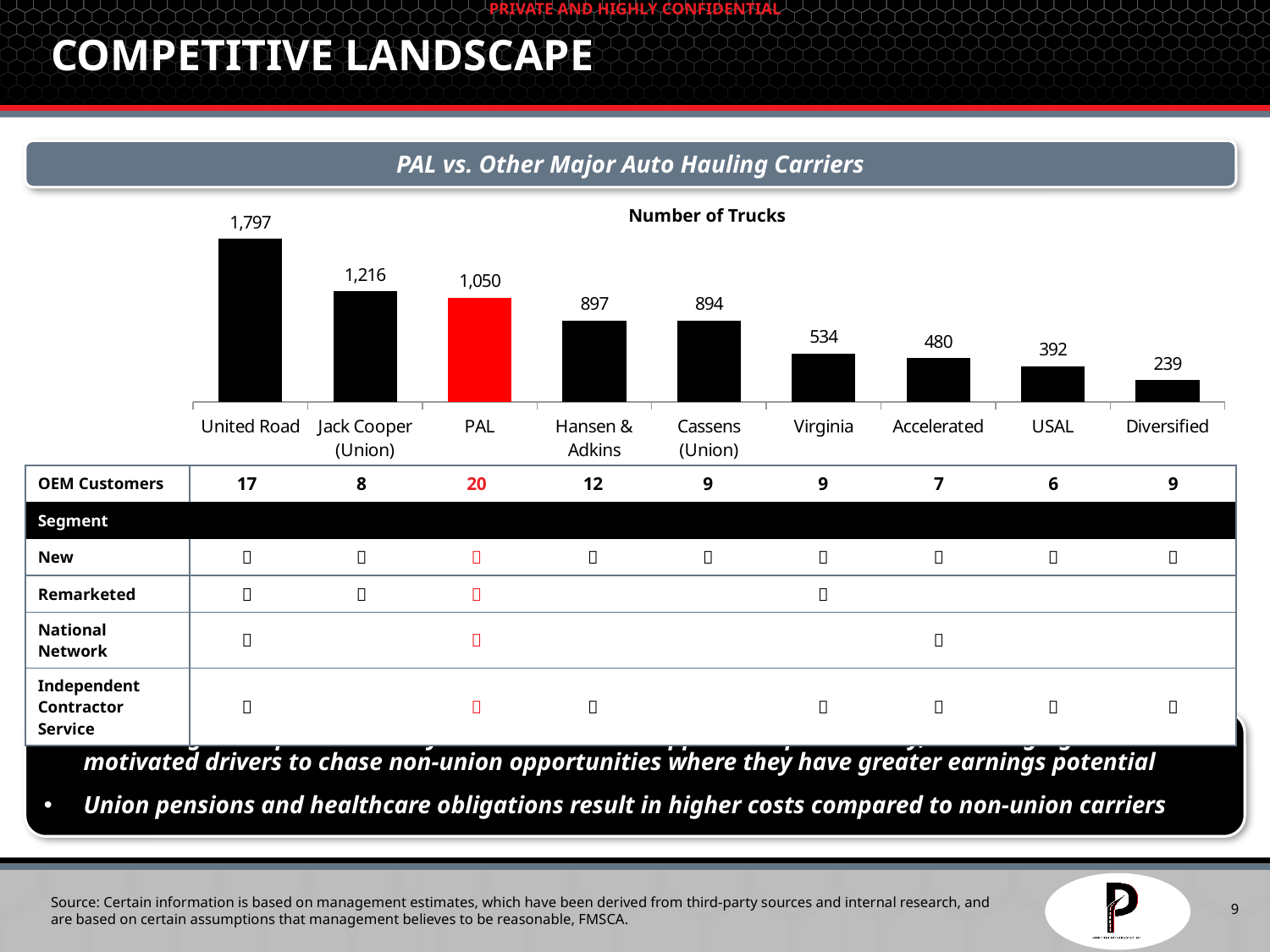
What is the number of trucks for PAL? 1,050 Which has more trucks, Virginia or Accelerated? Virginia Which carrier has the highest number of trucks? United Road What is the difference in number of trucks between PAL and Hansen & Adkins? 153 What is the number of trucks for Cassens (Union)? 894 What is the difference in number of trucks between United Road and Jack Cooper (Union)? 581 What is the title of the chart? Number of Trucks What kind of chart is used to show the number of trucks? Bar chart How many carriers are shown in the Number of Trucks chart? 9 Which carrier has the lowest number of trucks? Diversified Do the number of trucks values rise or fall from left to right across the chart? Fall Which carrier's bar is coloured red in the chart? PAL